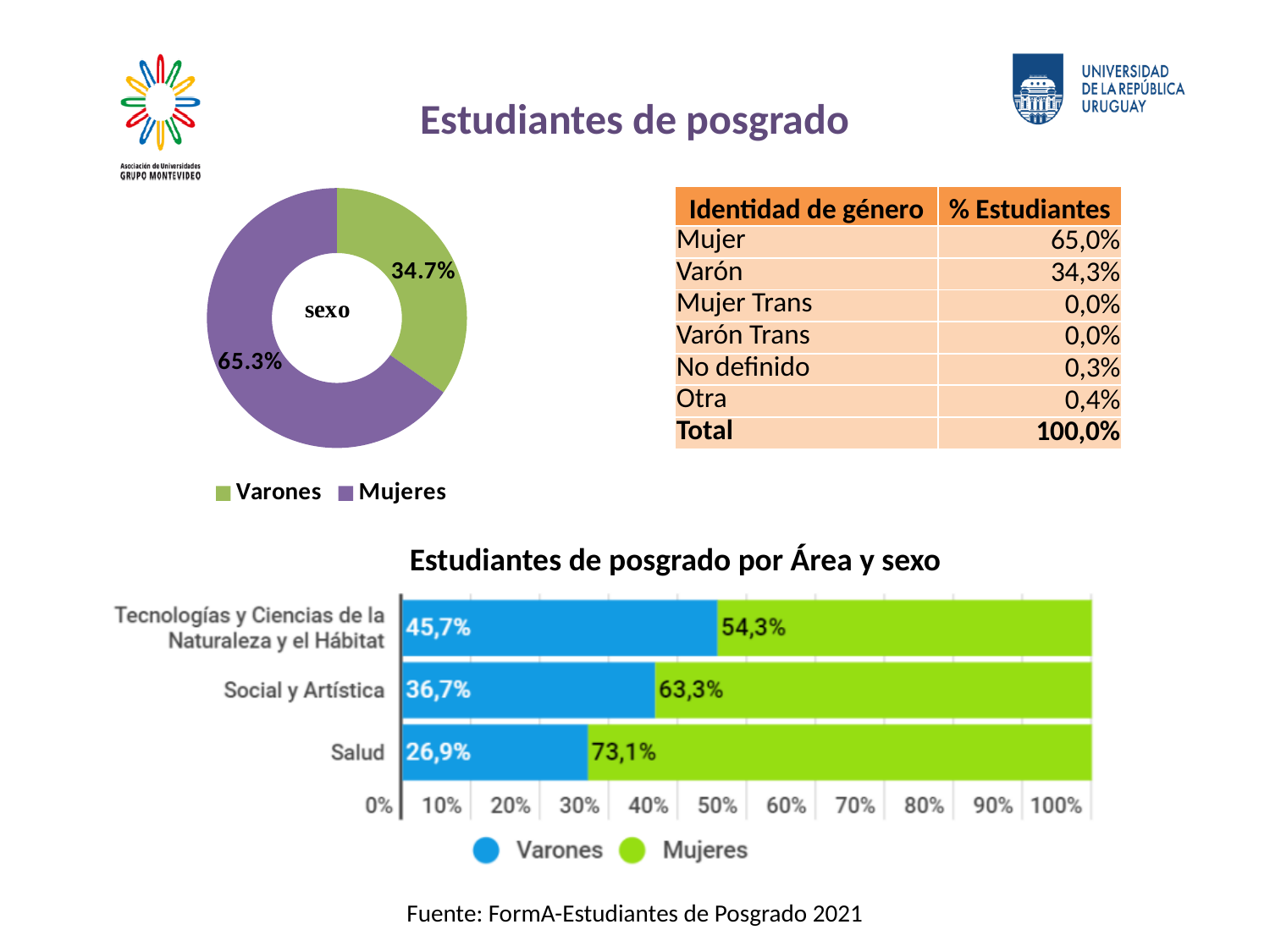
In the chart "Estudiantes de posgrado por Área y sexo", which area has the highest Mujeres share? Salud In the donut chart labelled "sexo", which group has the larger share, Varones or Mujeres? Mujeres In the donut chart labelled "sexo", what percentage is shown for Varones? 34.7% What kind of chart is "Estudiantes de posgrado por Área y sexo"? Stacked bar chart In the donut chart labelled "sexo", how many entries does the legend list? 2 In the chart "Estudiantes de posgrado por Área y sexo", which area has the lowest Varones share? Salud In the chart "Estudiantes de posgrado por Área y sexo", what is the Varones value for Tecnologías y Ciencias de la Naturaleza y el Hábitat? 45,7% In the chart "Estudiantes de posgrado por Área y sexo", what is the Mujeres value for Social y Artística? 63,3% In the chart "Estudiantes de posgrado por Área y sexo", how many areas are shown? 3 In the donut chart labelled "sexo", what is the difference in percentage points between Mujeres and Varones? 30.6 In the chart "Estudiantes de posgrado por Área y sexo", what is the Varones value for Salud? 26,9% In the donut chart labelled "sexo", what percentage is shown for Mujeres? 65.3%